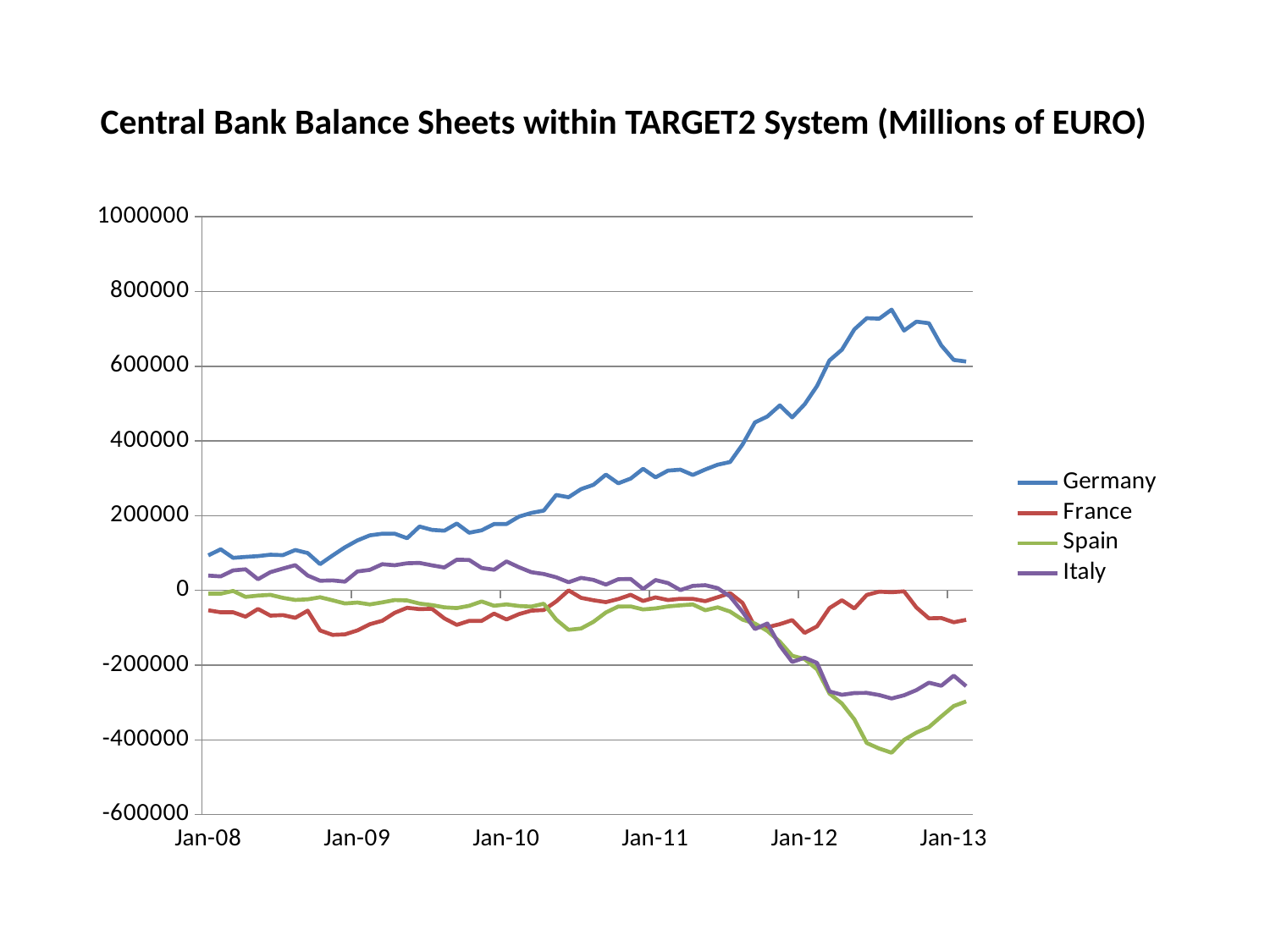
Is the value for Italy at Jan-13 greater or less than -400000? greater Is the value for Germany at Jan-13 greater or less than 400000? greater How many series does the legend list? 4 Which is larger at Jan-13, the value for Germany or the value for France? Germany What kind of chart is shown on the slide? Line chart Which series reaches the lowest value on the chart? Spain Does the value for Germany rise or fall between Jan-08 and Jan-12? rise Which series is shown in blue in the legend? Germany Is the peak value for Germany greater or less than 600000? greater What is the title of the chart? Central Bank Balance Sheets within TARGET2 System (Millions of EURO) Which series reaches the highest value on the chart? Germany